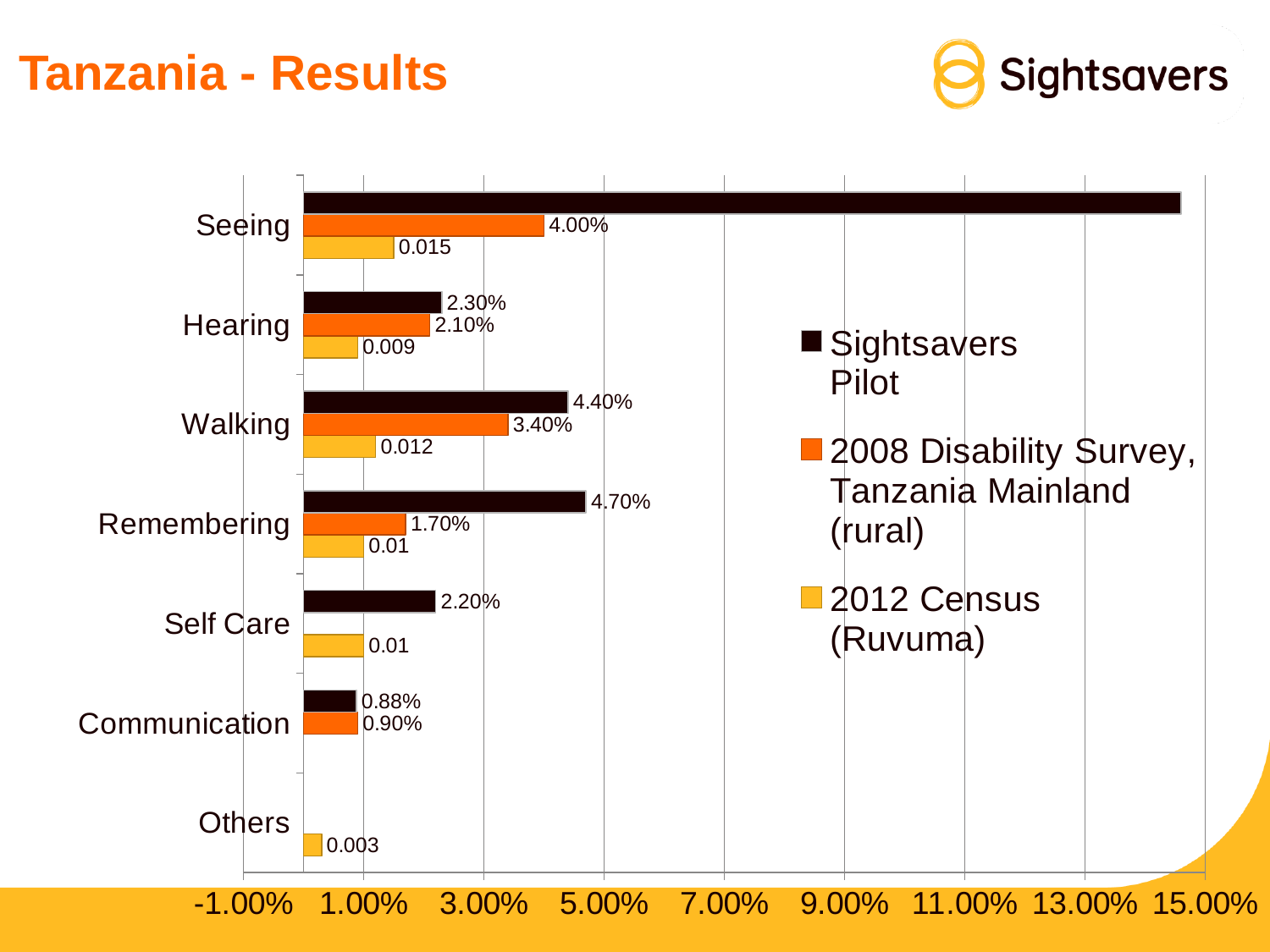
Which category has the highest Sightsavers Pilot value? Seeing What is the 2008 Disability Survey, Tanzania Mainland (rural) value for Seeing? 4.00% For Communication, which is larger: the Sightsavers Pilot value or the 2008 Disability Survey value? 2008 Disability Survey Is the Sightsavers Pilot value for Seeing greater or less than 13.00%? greater What is the difference between the Sightsavers Pilot and 2008 Disability Survey values for Walking? 1.00% What colour represents the 2012 Census (Ruvuma) series in the legend? yellow What is the 2012 Census (Ruvuma) value for Hearing? 0.009 How many categories are shown on the vertical axis? 7 How many series does the legend list? 3 What is the Sightsavers Pilot value for Remembering? 4.70% What kind of chart is shown on the slide? bar chart What is the 2012 Census (Ruvuma) value for Others? 0.003